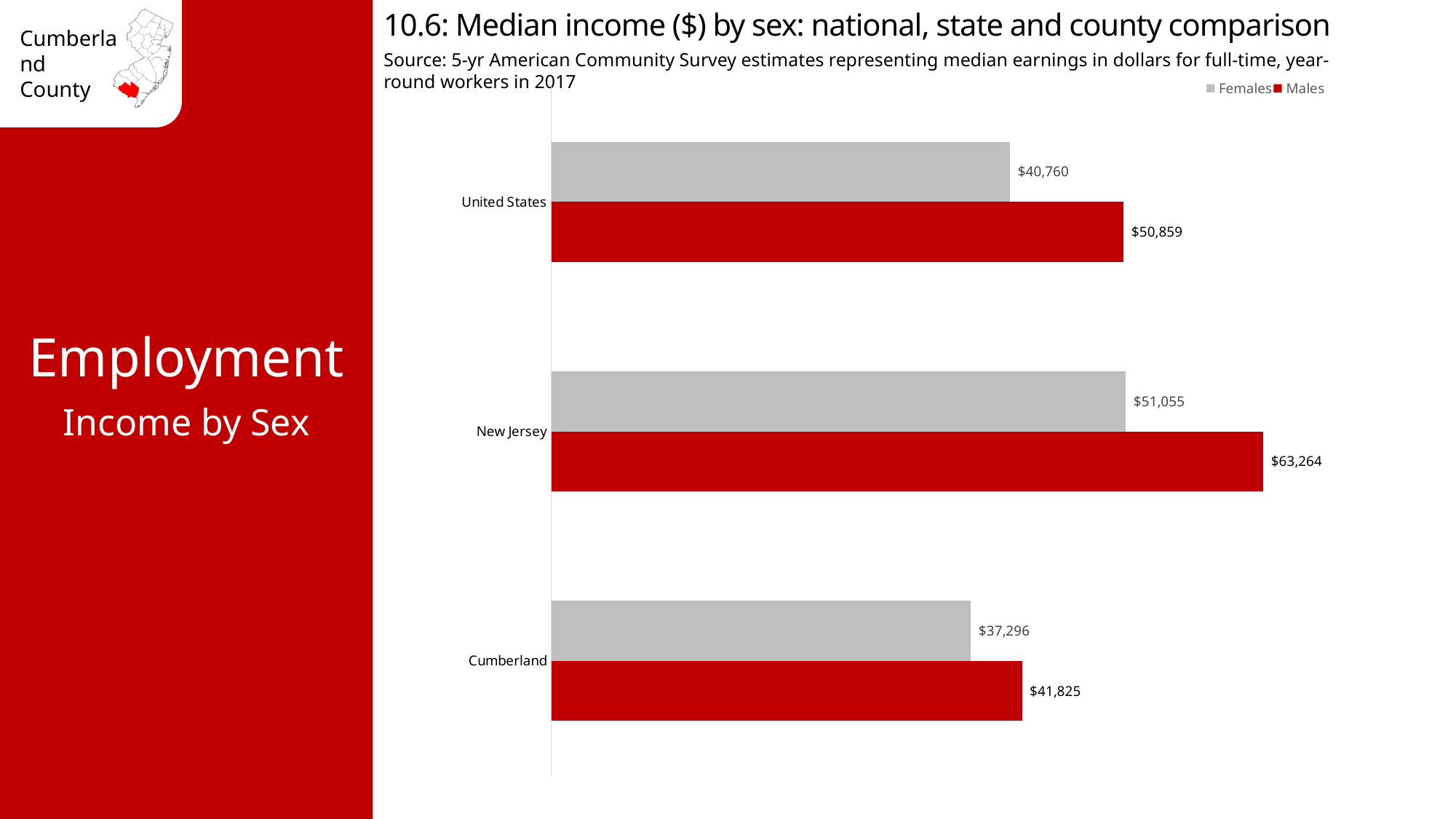
How many geographies are shown on the chart? 3 What is the median income for Females in Cumberland? $37,296 Which geography has the lowest median income for Females? Cumberland Which is larger: the Females median income in New Jersey or the Males median income in the United States? Females median income in New Jersey What is the difference between Males and Females median income in New Jersey? $12,209 What is the median income for Males in New Jersey? $63,264 What is the median income for Females in the United States? $40,760 How many series does the legend list? 2 What kind of chart is shown on the slide? Bar chart Which geography has the highest median income for Males? New Jersey What is the difference between Males and Females median income in Cumberland? $4,529 What is the median income for Males in Cumberland? $41,825